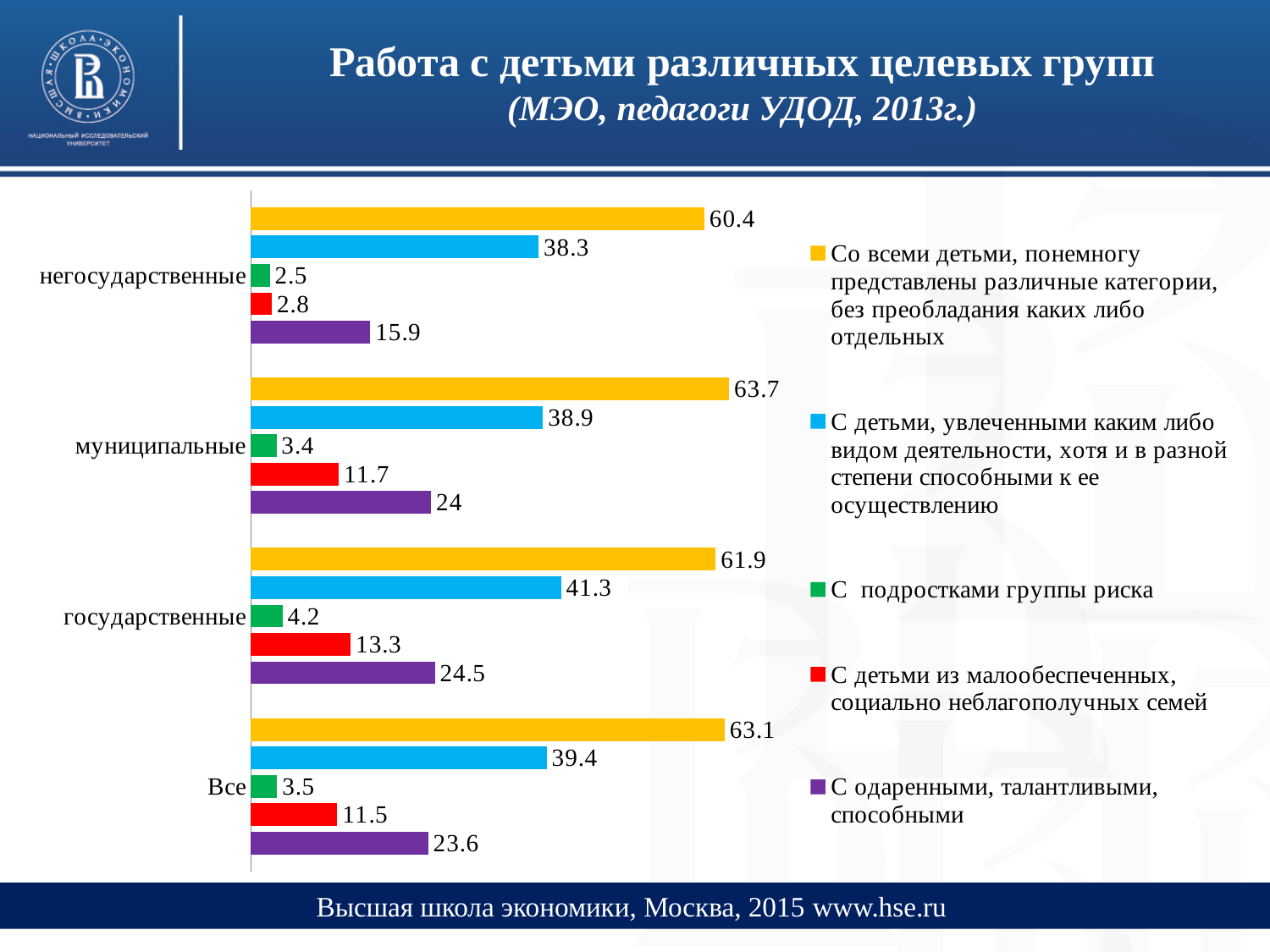
What is the value for 'С подростками группы риска' in the 'негосударственные' category? 2.5 What is the value for 'С одаренными, талантливыми, способными' in the 'Все' category? 23.6 What is the value for 'Со всеми детьми, понемногу представлены различные категории, без преобладания каких либо отдельных' in the 'муниципальные' category? 63.7 What kind of chart is shown on the slide? Bar chart Which category has the highest value for 'С детьми, увлеченными каким либо видом деятельности, хотя и в разной степени способными к ее осуществлению'? государственные Which is larger: the 'С одаренными, талантливыми, способными' value for 'государственные' or for 'муниципальные'? государственные Which colour represents 'С подростками группы риска' in the legend? Green How many categories are shown on the chart? 4 How many series does the legend list? 5 What is the difference between the 'Со всеми детьми...' values for 'муниципальные' and 'негосударственные'? 3.3 What is the value for 'С детьми из малообеспеченных, социально неблагополучных семей' in the 'государственные' category? 13.3 Which category has the lowest value for 'С детьми из малообеспеченных, социально неблагополучных семей'? негосударственные